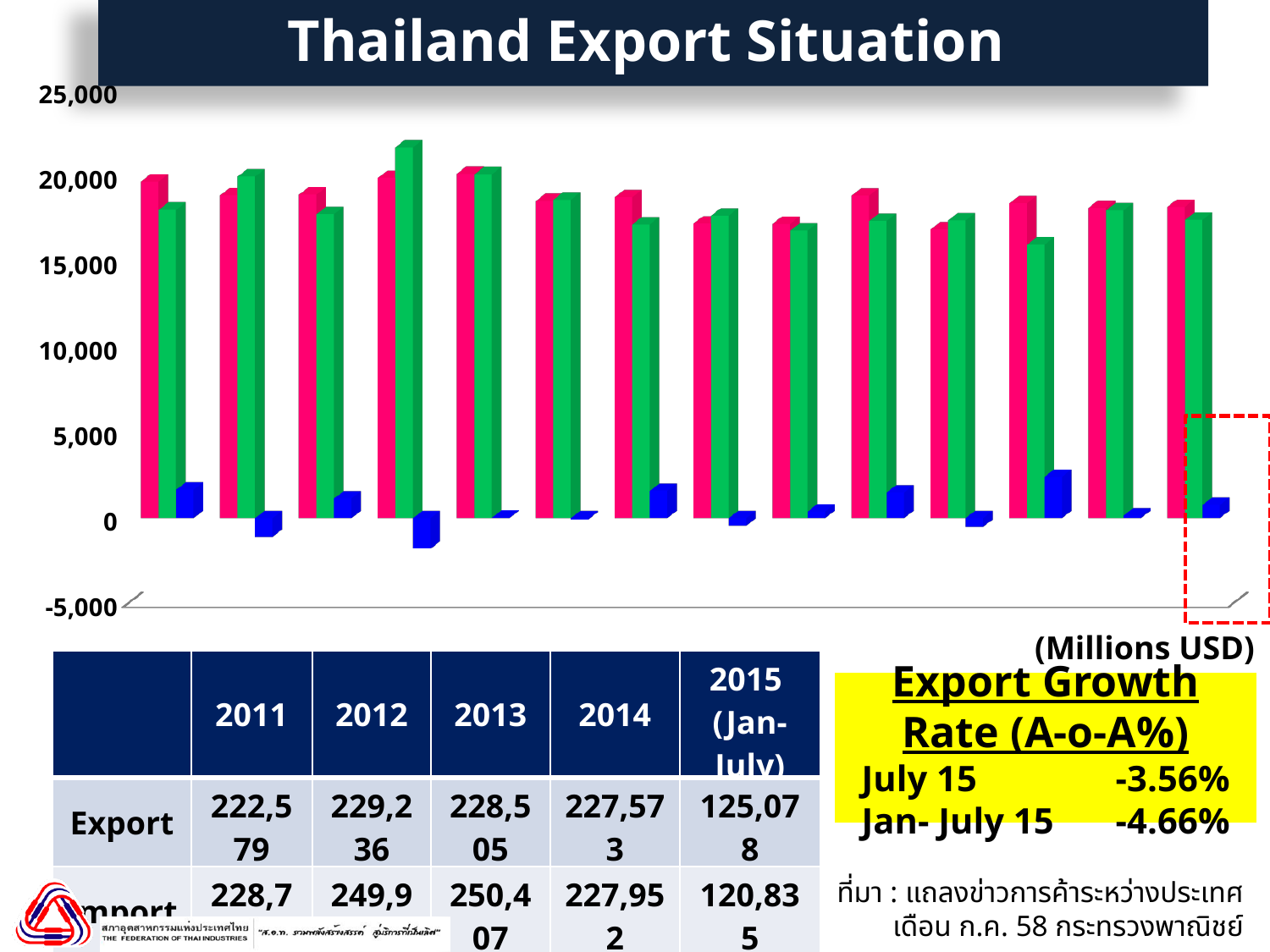
In what unit are the chart values expressed, according to the note below the chart? Millions USD How many groups of bars are plotted along the x axis of the chart? 14 How many differently coloured bar series are plotted in each group of the chart? 3 Are all of the blue bars on the chart greater or less than 5,000? less What type of chart is shown on the slide? bar chart Which colour of bar is the tallest in the fourth group of bars from the left? green What is the title of the chart on the slide? Thailand Export Situation Are all of the pink bars on the chart greater or less than 15,000? greater Is the tallest green bar on the chart greater or less than 20,000? greater